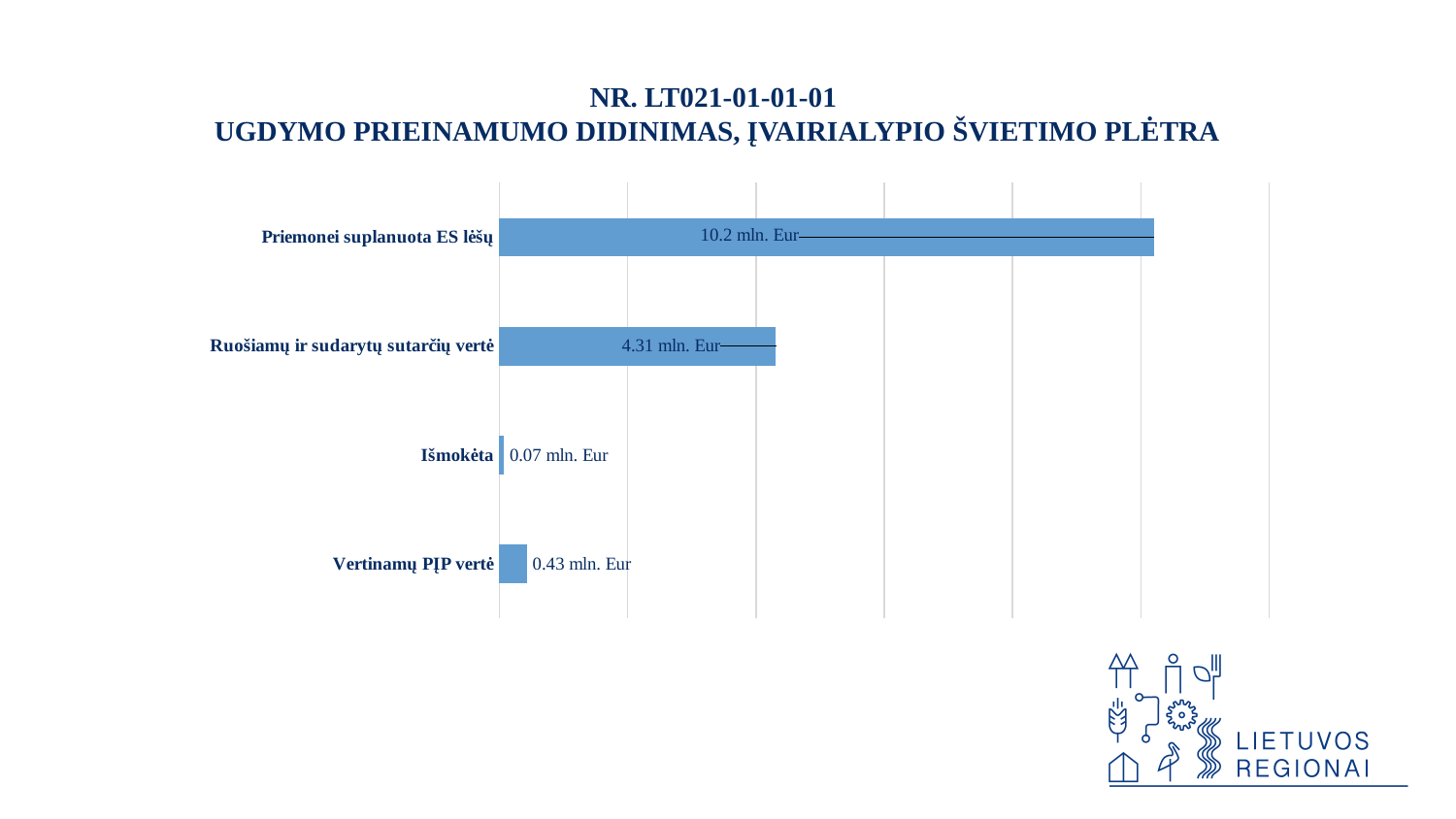
Which category has the highest value? Priemonei suplanuota ES lėšų What is the value for Vertinamų PĮP vertė? 0.43 mln. Eur What is the difference between Vertinamų PĮP vertė and Išmokėta? 0.36 mln. Eur What is the value for Priemonei suplanuota ES lėšų? 10.2 mln. Eur What is the difference between Priemonei suplanuota ES lėšų and Ruošiamų ir sudarytų sutarčių vertė? 5.89 mln. Eur Which is larger, Vertinamų PĮP vertė or Išmokėta? Vertinamų PĮP vertė What is the value for Išmokėta? 0.07 mln. Eur How many categories are shown in the chart? 4 What kind of chart is shown on the slide? Bar chart Which category has the lowest value? Išmokėta What is the value for Ruošiamų ir sudarytų sutarčių vertė? 4.31 mln. Eur What is the measure number shown in the title above the chart? NR. LT021-01-01-01